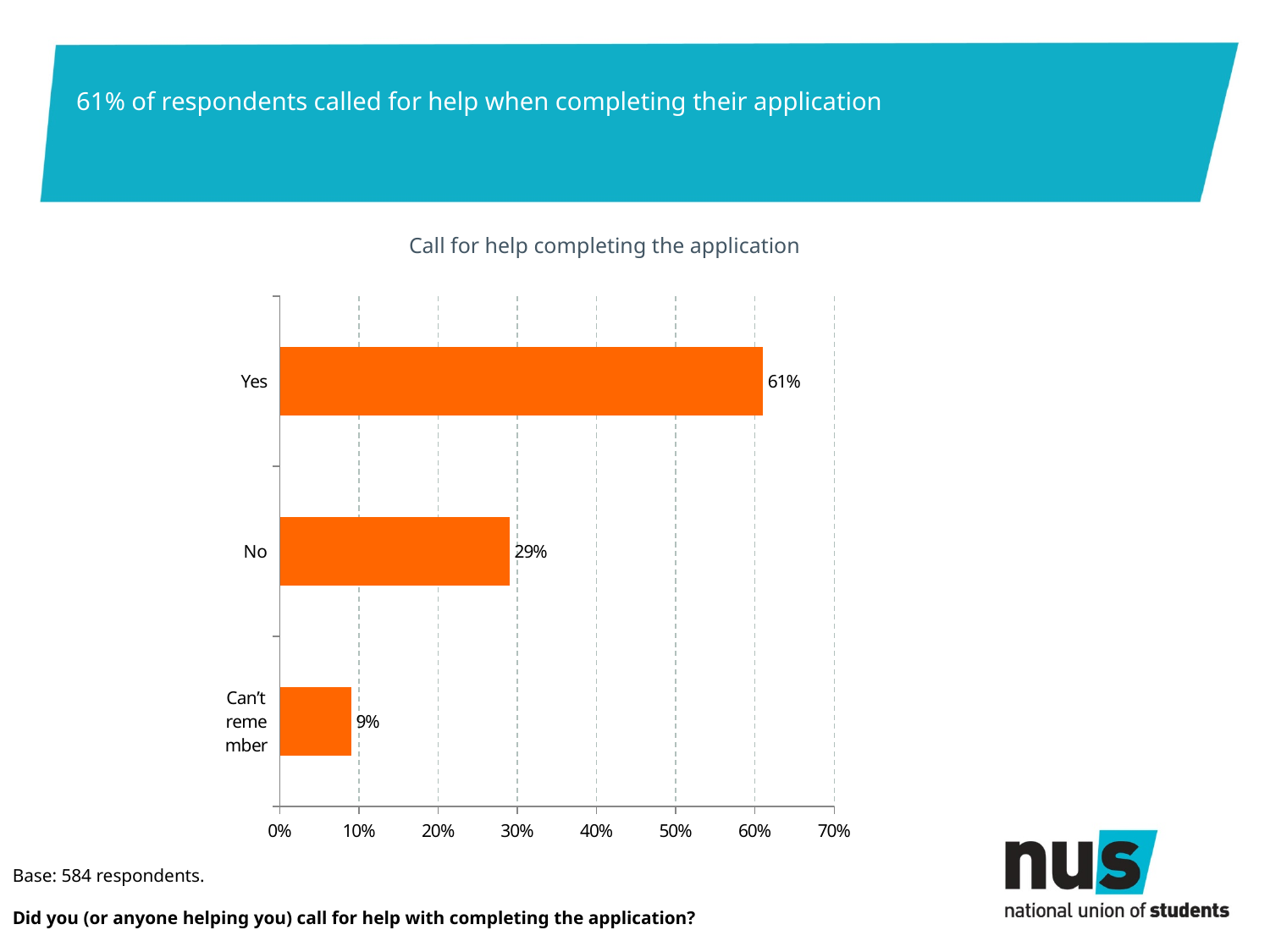
What percentage of respondents answered "Can't remember"? 9% Which is larger, the value for "No" or the value for "Can't remember"? No What type of chart is shown on the slide? Bar chart What is the title of the chart? Call for help completing the application Which response category has the highest value? Yes How many response categories are shown in the chart? 3 What percentage of respondents answered "No"? 29% What is the difference in percentage points between the "Yes" and "No" responses? 32 percentage points Is the value for "Yes" greater or less than 50%? greater What percentage of respondents answered "Yes" to calling for help completing the application? 61% Which response category has the lowest value? Can't remember What is the difference in percentage points between the "No" and "Can't remember" responses? 20 percentage points